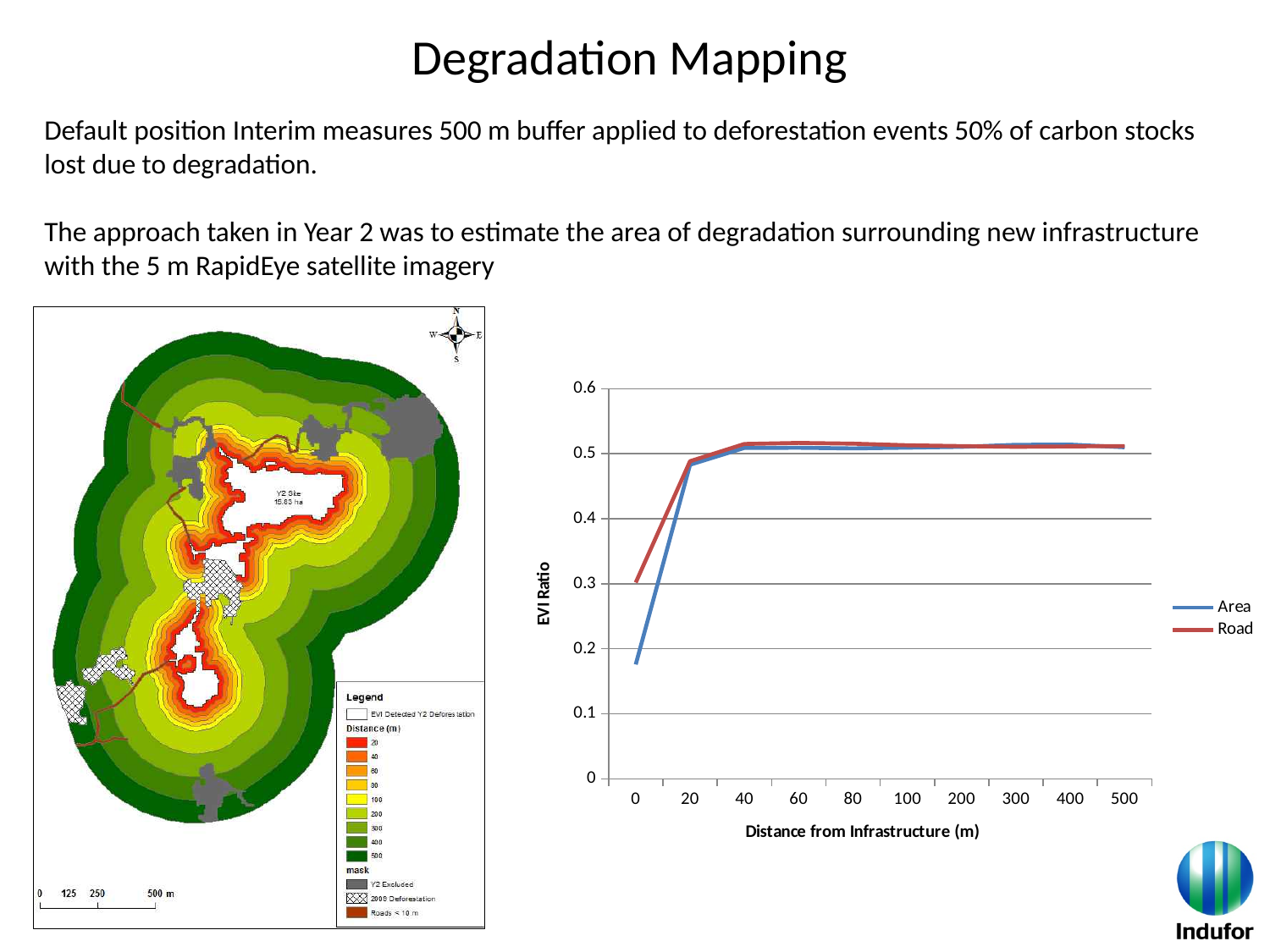
In the line chart, is the Area value at a distance of 100 m greater or less than 0.4? greater In the line chart, at a distance of 0 m, which series has the larger EVI Ratio, Area or Road? Road In the line chart, is the Area value at a distance of 0 m greater or less than 0.2? less What are the two series named in the legend of the line chart? Area and Road How many distance values are marked along the x axis of the line chart? 10 How many series does the legend of the line chart list? 2 In the line chart, at which distance is the Area series at its lowest? 0 What is the label of the y axis of the line chart? EVI Ratio In the line chart, does the Area series rise or fall between 0 m and 20 m? rise In the line chart, is the Road value at a distance of 0 m greater or less than 0.2? greater What kind of chart is shown on the right of the slide? line chart